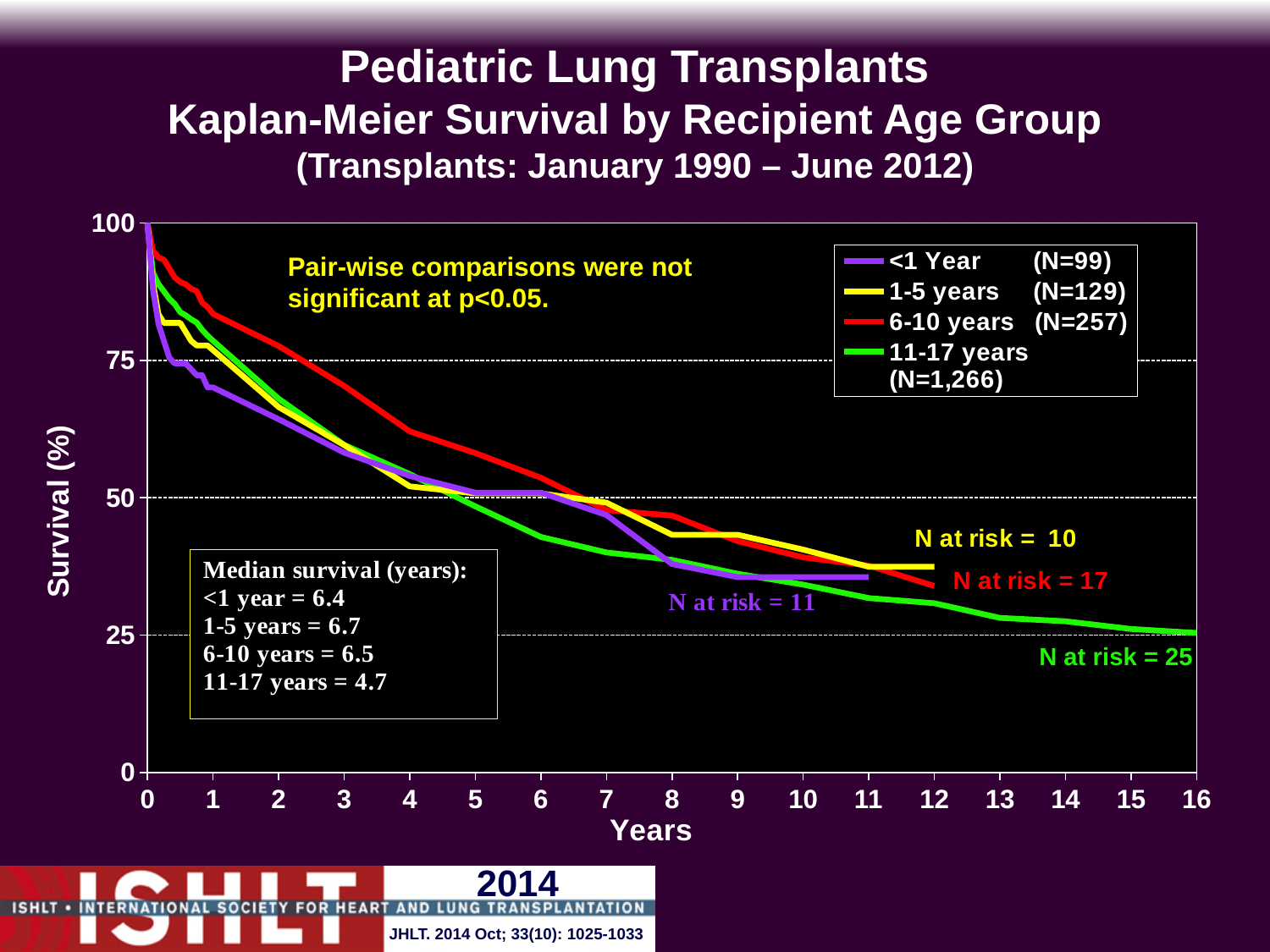
Is the survival for the 6-10 years group at 1 year greater or less than 75? greater Do the survival curves rise or fall as years increase? fall What is the difference in median survival (years) between the 1-5 years group and the 11-17 years group? 2.0 Which group has a larger N in the legend, <1 Year or 1-5 years? 1-5 years What is the median survival in years for the 11-17 years group? 4.7 What is the N for the 6-10 years group shown in the legend? 257 What is the N at risk shown for the 11-17 years group? 25 Is the survival for the 11-17 years group at 10 years greater or less than 50? less What kind of chart is shown on the slide? line chart How many series does the legend list? 4 Which recipient age group has the lowest median survival? 11-17 years Which recipient age group has the highest median survival? 1-5 years